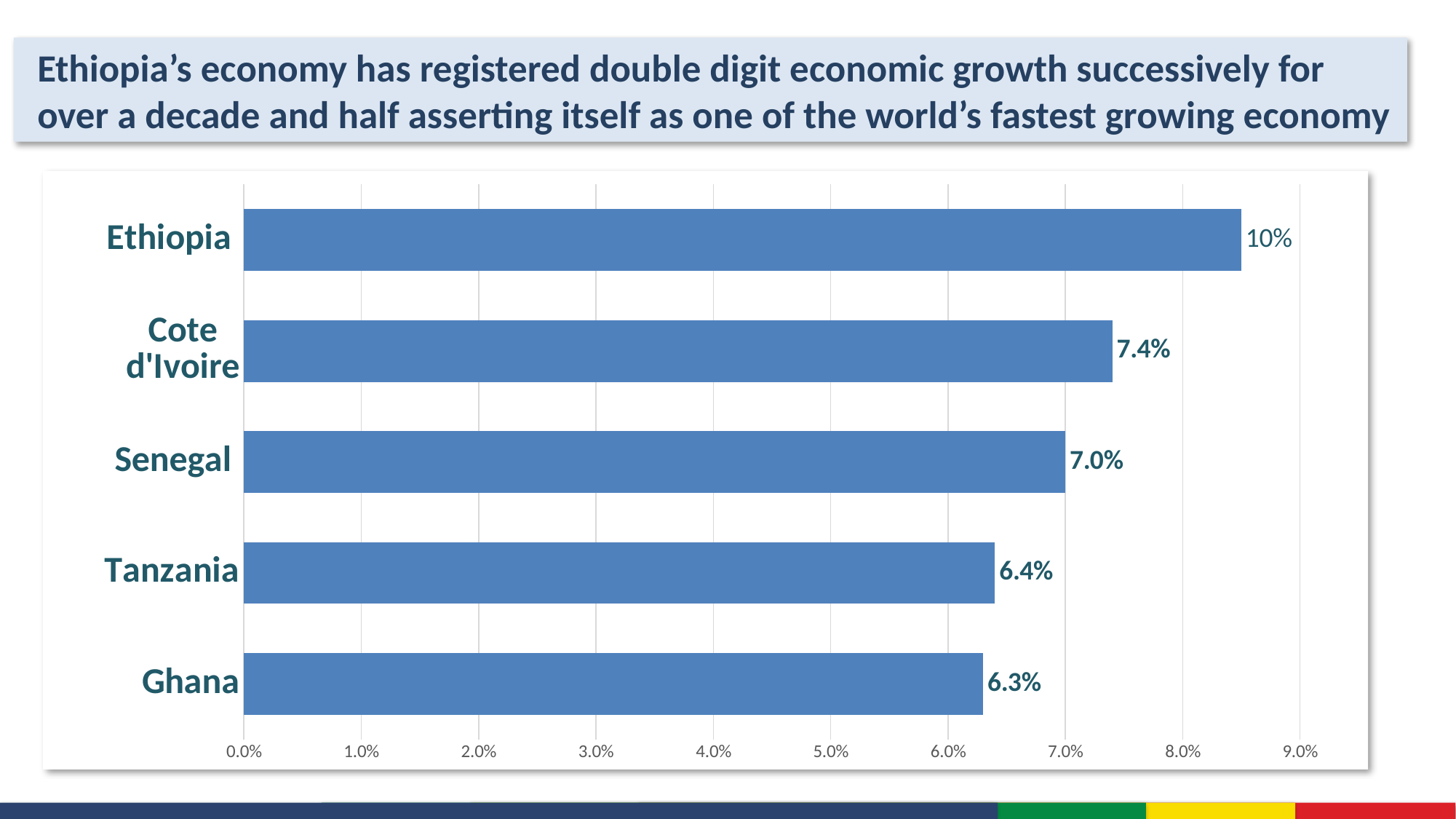
What kind of chart is shown on the slide? bar chart Which country has the highest value in the chart? Ethiopia What is the value shown for Cote d'Ivoire? 7.4% Which has a larger value, Senegal or Tanzania? Senegal Which country has the lowest value in the chart? Ghana What is the value shown for Ethiopia? 10% What is the value shown for Senegal? 7.0% What is the difference between the values for Cote d'Ivoire and Senegal? 0.4% How many countries are shown in the chart? 5 What is the value shown for Ghana? 6.3% What is the value shown for Tanzania? 6.4% Is the value for Ghana greater or less than 7.0%? less